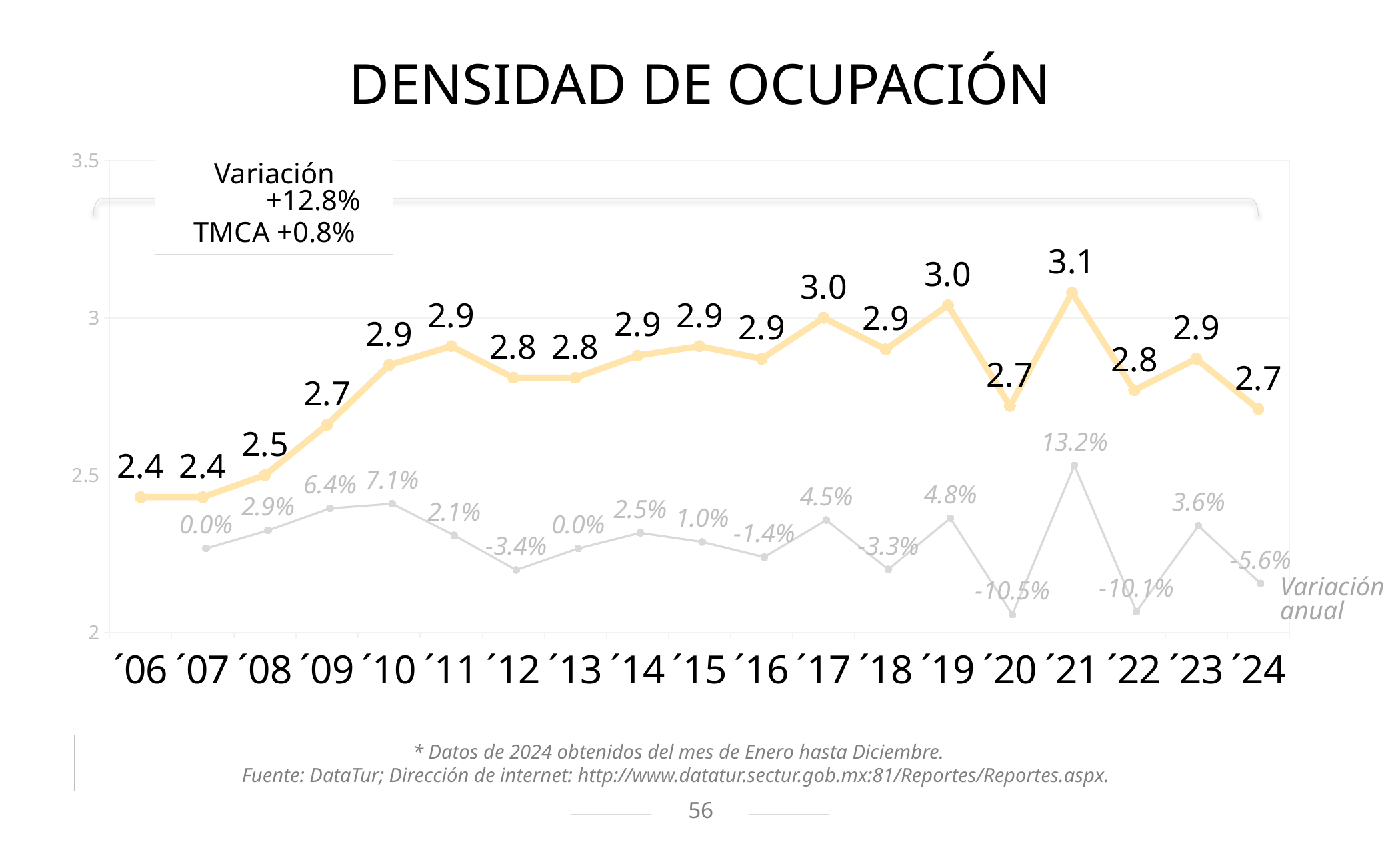
What is the densidad de ocupación value for ´24? 2.7 What is the variación anual value shown for ´21? 13.2% What TMCA value is shown in the text box on the chart? +0.8% Which year has the lowest variación anual value? ´20 Which year has the highest densidad de ocupación value? ´21 Does the densidad de ocupación value rise or fall from ´06 to ´10? rise How many years are plotted on the x axis? 19 Which year has a larger densidad de ocupación value, ´09 or ´10? ´10 What is the difference between the densidad de ocupación values for ´21 and ´20? 0.4 What type of chart is shown on the slide? line chart What is the variación anual value shown for ´20? -10.5% What is the densidad de ocupación value for ´17? 3.0